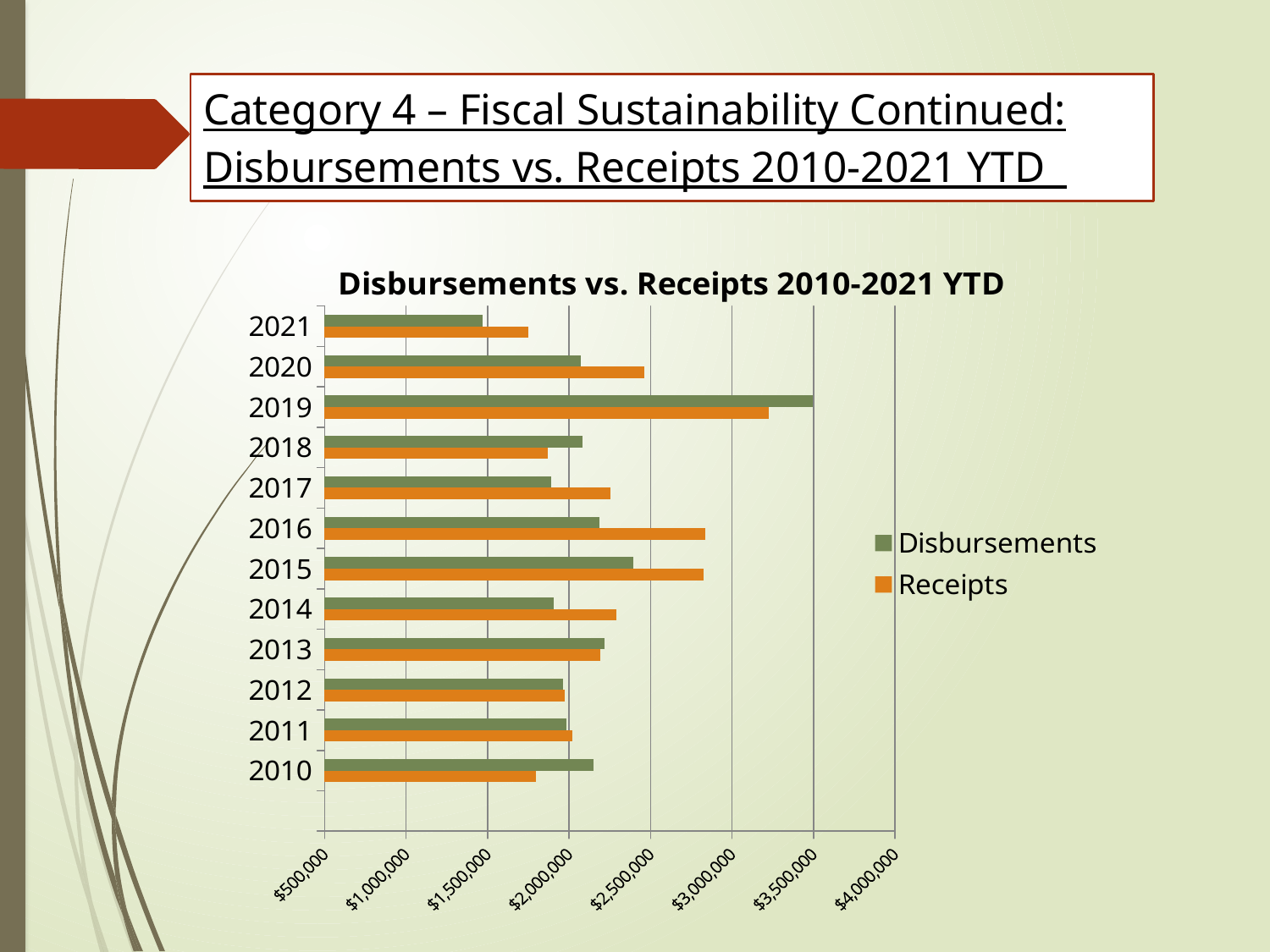
In 2010, which was larger, Disbursements or Receipts? Disbursements How many years are shown on the y axis of the chart? 12 In 2019, which was larger, Disbursements or Receipts? Disbursements What colour represents Receipts in the chart? Orange Is the value for Receipts in 2021 greater or less than $2,000,000? less In 2016, which was larger, Disbursements or Receipts? Receipts In which year were Disbursements lowest? 2021 Is the value for Disbursements in 2019 greater or less than $3,000,000? greater What kind of chart is shown on the slide? Bar chart In which year were Receipts highest? 2019 In which year were Disbursements highest? 2019 How many series does the legend list in the Disbursements vs. Receipts chart? 2